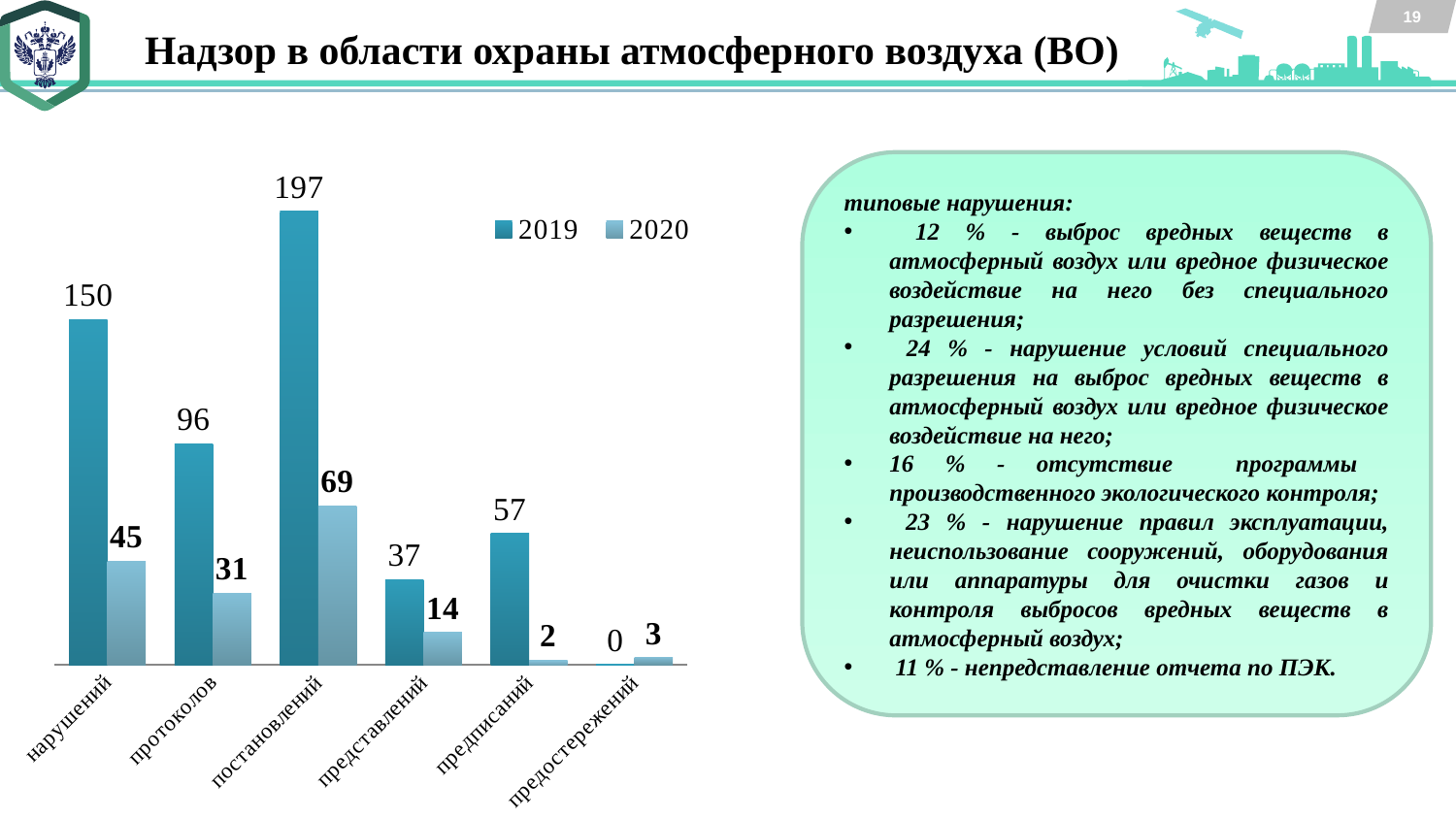
What is the 2020 value for предостережений? 3 What is the 2020 value for нарушений? 45 What is the 2019 value for предписаний? 57 What kind of chart is shown on the slide? bar chart Which is larger: the 2019 value for представлений or the 2020 value for постановлений? 2020 value for постановлений How many categories are shown on the x axis of the chart? 6 What is the 2019 value for постановлений? 197 Which category has the lowest 2020 value? предписаний Which category has the highest 2019 value? постановлений How many series does the legend list? 2 What is the difference between the 2019 and 2020 values for протоколов? 65 What are the two series named in the chart legend? 2019 and 2020